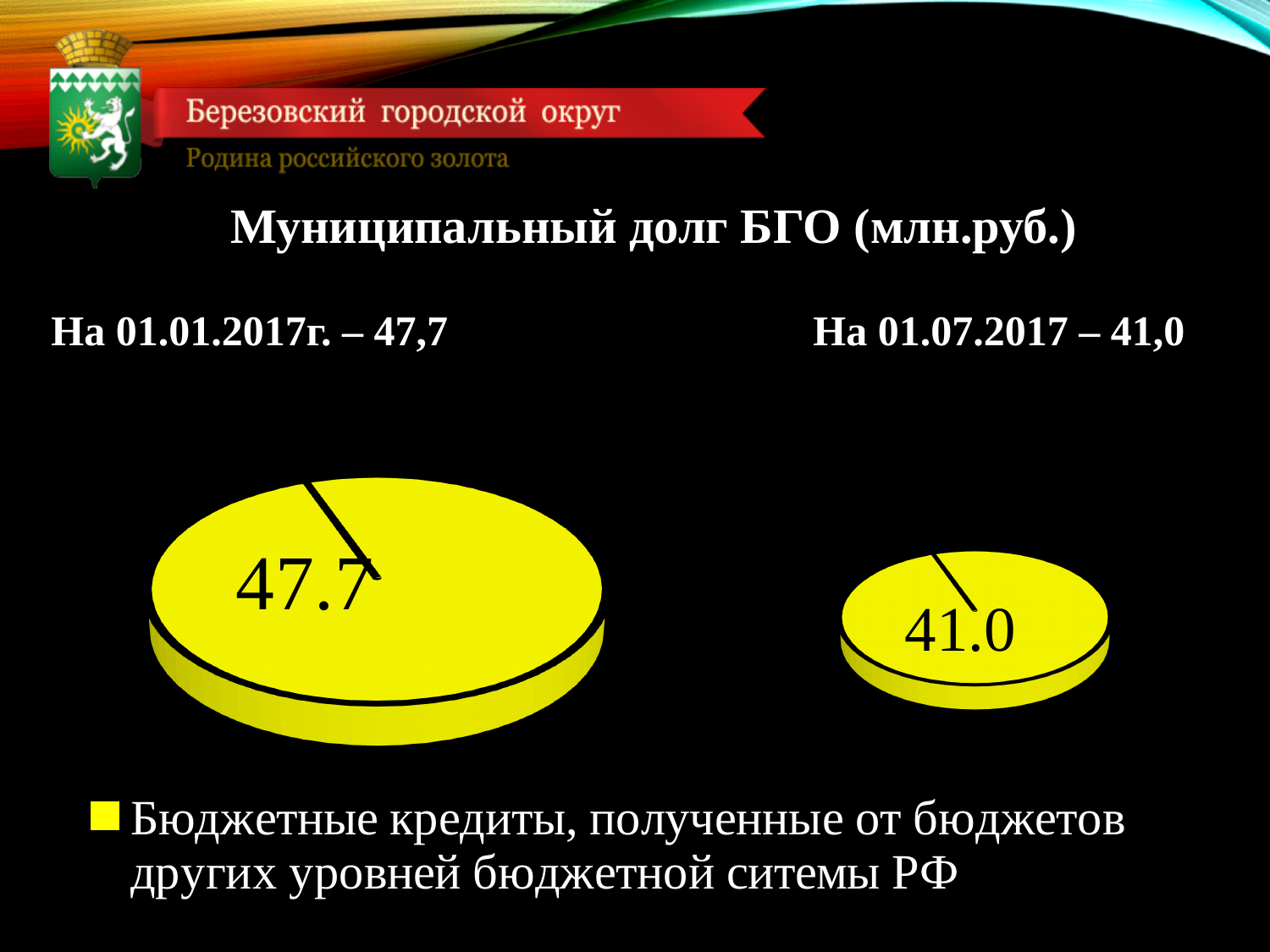
How many entries does the legend list? 1 What kind of charts are shown on the slide? Pie charts What is the difference between the value on the left pie chart (47.7) and the value on the right pie chart (41.0)? 6.7 What value is shown on the left pie chart (as of 01.01.2017)? 47.7 How many slices does the left pie chart have? 1 Which pie chart shows the larger value, the left one (01.01.2017) or the right one (01.07.2017)? The left one (01.01.2017) What share of the right pie chart does its single slice take up? 100% What is the title above the charts? Муниципальный долг БГО (млн.руб.) What value is shown on the right pie chart (as of 01.07.2017)? 41.0 How many pie charts are on the slide? 2 What colour are the pie charts? Yellow Did the municipal debt rise or fall from 01.01.2017 to 01.07.2017? Fall